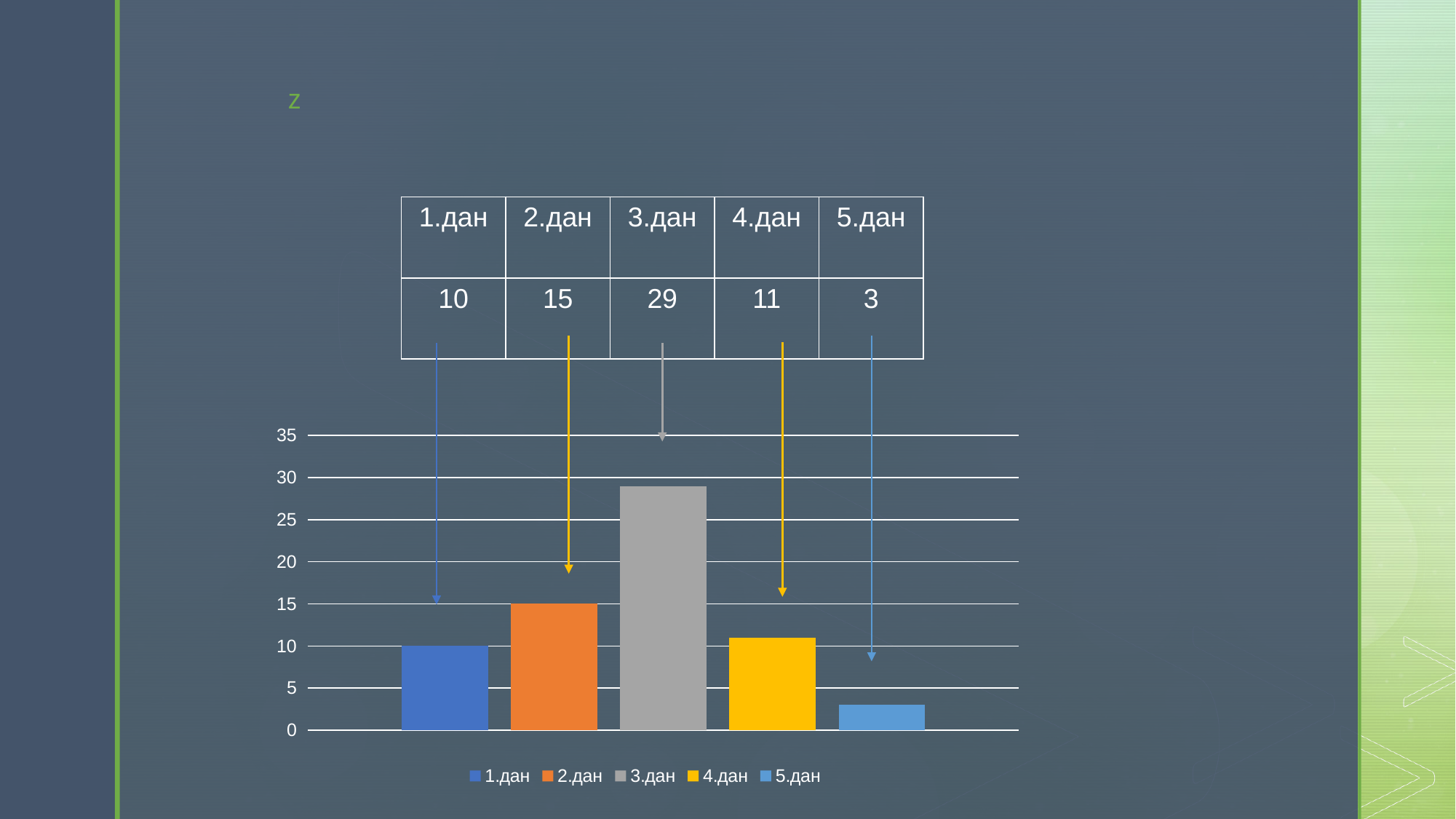
What is the value for 1.дан? 10 What kind of chart is shown on the slide? bar chart What is the difference between the values for 3.дан and 2.дан? 14 Which category has the highest value? 3.дан What is the value for 5.дан? 3 Is the value for 3.дан greater or less than 25? greater What colour is the bar for 3.дан? grey Which is larger, the value for 2.дан or the value for 4.дан? 2.дан Which category has the lowest value? 5.дан How many entries does the legend list? 5 How many bars are plotted in the chart? 5 What is the value for 3.дан? 29